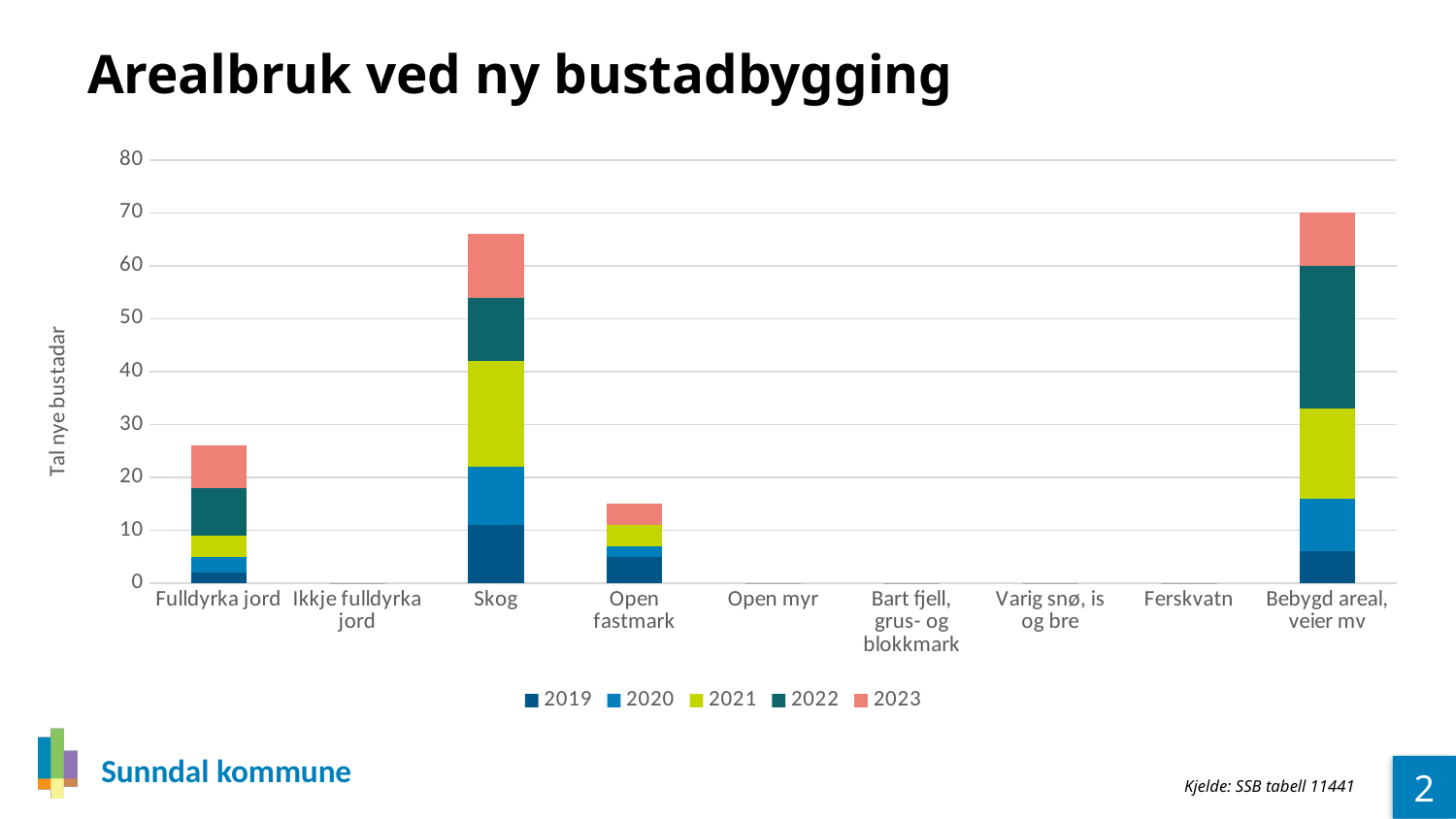
How many categories are shown along the x axis? 9 Which has a taller stacked bar, Open fastmark or Fulldyrka jord? Fulldyrka jord Is the total stacked value for Bebygd areal, veier mv greater or less than 60? greater What kind of chart is shown on the slide? Stacked bar chart Is the total stacked value for Skog greater or less than 60? greater Is the total stacked value for Open fastmark greater or less than 20? less What is the label on the y axis? Tal nye bustadar How many series does the legend list? 5 Which category has the tallest stacked bar? Bebygd areal, veier mv Which has a taller stacked bar, Skog or Fulldyrka jord? Skog What is the title of the chart? Arealbruk ved ny bustadbygging